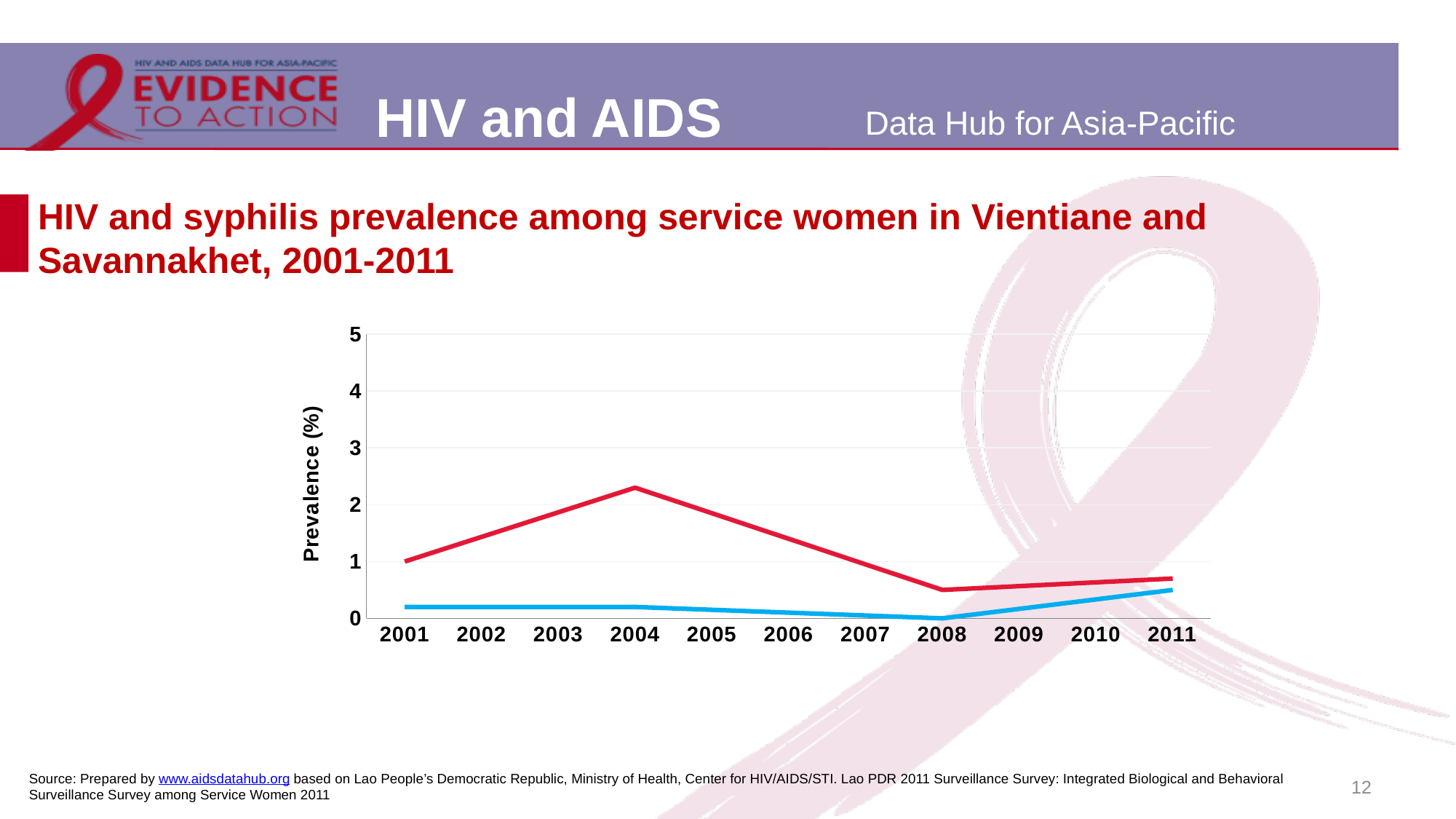
Does the red line rise or fall between 2004 and 2008? fall What is the title of the chart? HIV and syphilis prevalence among service women in Vientiane and Savannakhet, 2001-2011 Does the blue line rise or fall between 2008 and 2011? rise Is the value of the blue line in 2011 greater or less than 1? less What is the label of the y axis? Prevalence (%) Is the value of the red line in 2004 greater or less than 2? greater Which line has the higher value in 2004, the red line or the blue line? the red line What kind of chart is shown on the slide? line chart Is the value of the red line in 2008 greater or less than 1? less In which year does the red line reach its highest value? 2004 In which year does the red line reach its lowest value? 2008 How many years are shown on the x axis of the chart? 11